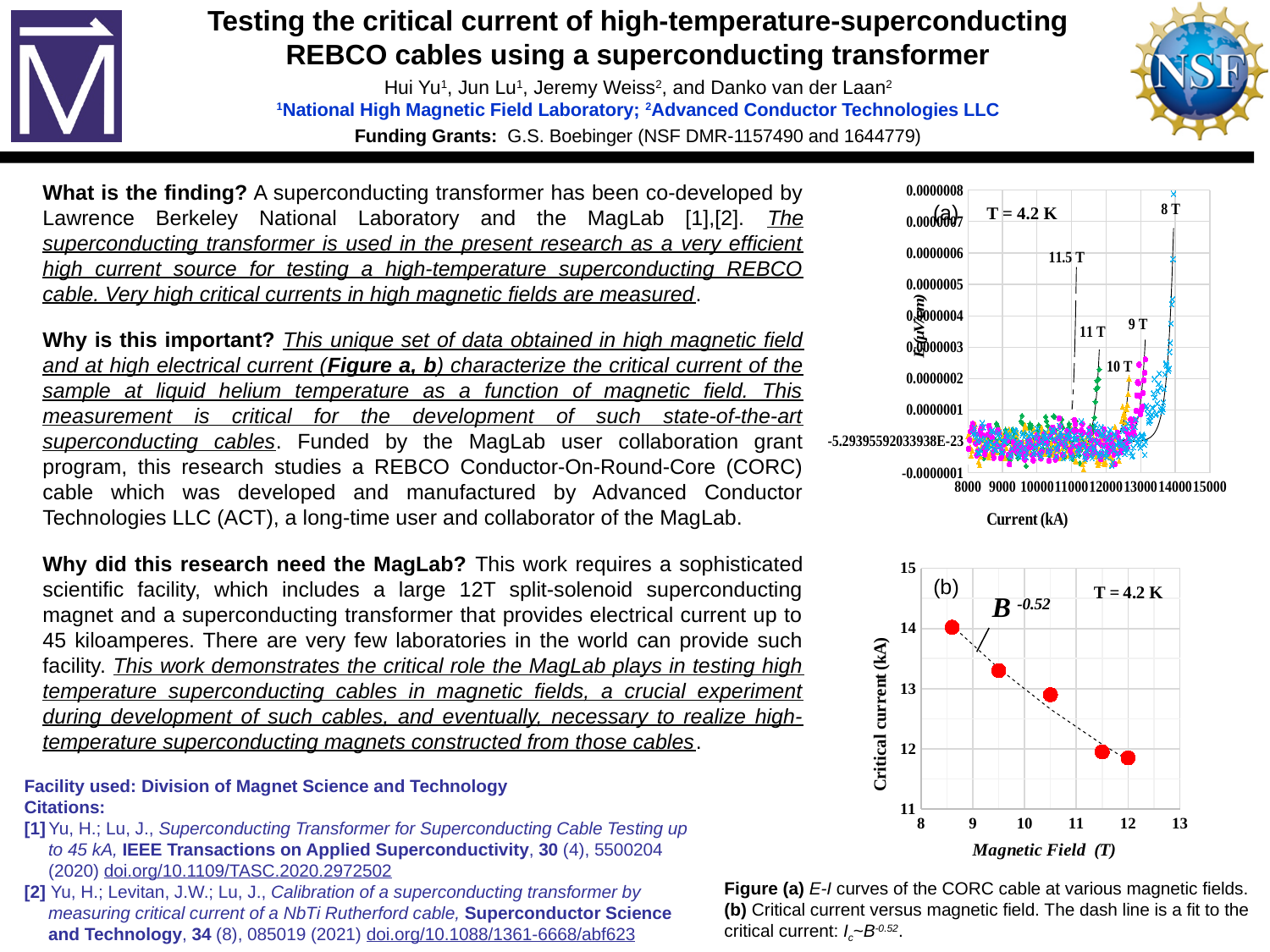
In chart (b), is the critical current at the lowest magnetic field shown greater or less than 13 kA? greater In chart (a), what is the highest magnetic field labeled on the curves? 11.5 T In chart (b), does the critical current rise or fall as the magnetic field increases? fall In chart (a), what temperature is stated for the measurements? T = 4.2 K In chart (b), is the critical current at the highest magnetic field shown greater or less than 14 kA? less In chart (a), how many magnetic field values are labeled on the E-I curves? 5 In chart (a), does the 8 T curve or the 11 T curve reach its sharp rise in E at a higher current? 8 T In chart (b), what kind of chart is used to show critical current versus magnetic field? scatter plot In chart (a), which magnetic field curve shows its sharp rise in E at the highest current? 8 T In chart (b), what exponent of B is given for the fit to the critical current? -0.52 In chart (b), is the critical current at 12 T greater or less than 13 kA? less In chart (a), which magnetic field curve shows its sharp rise in E at the lowest current? 11.5 T